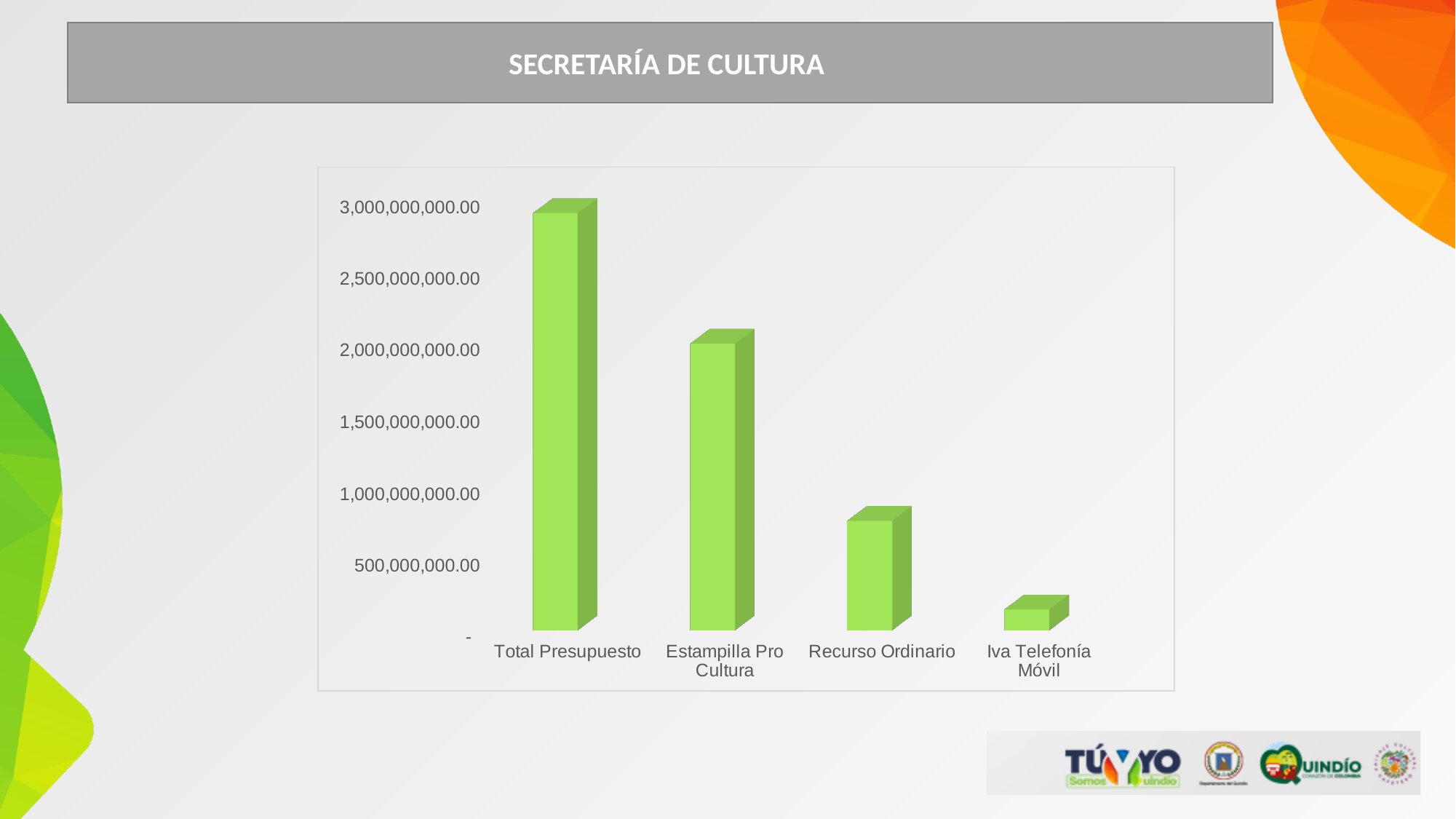
Is the value for Total Presupuesto greater or less than 2,500,000,000.00? greater Which is larger, the value for Estampilla Pro Cultura or the value for Recurso Ordinario? Estampilla Pro Cultura Which category has the highest value? Total Presupuesto What kind of chart is shown on the slide? bar chart Is the value for Recurso Ordinario greater or less than 1,000,000,000.00? less Do the bar values rise or fall from left to right across the categories? fall Which category has the lowest value? Iva Telefonía Móvil Is the value for Recurso Ordinario greater or less than 500,000,000.00? greater How many categories are plotted on the chart? 4 What is the title shown at the top of the slide? SECRETARÍA DE CULTURA